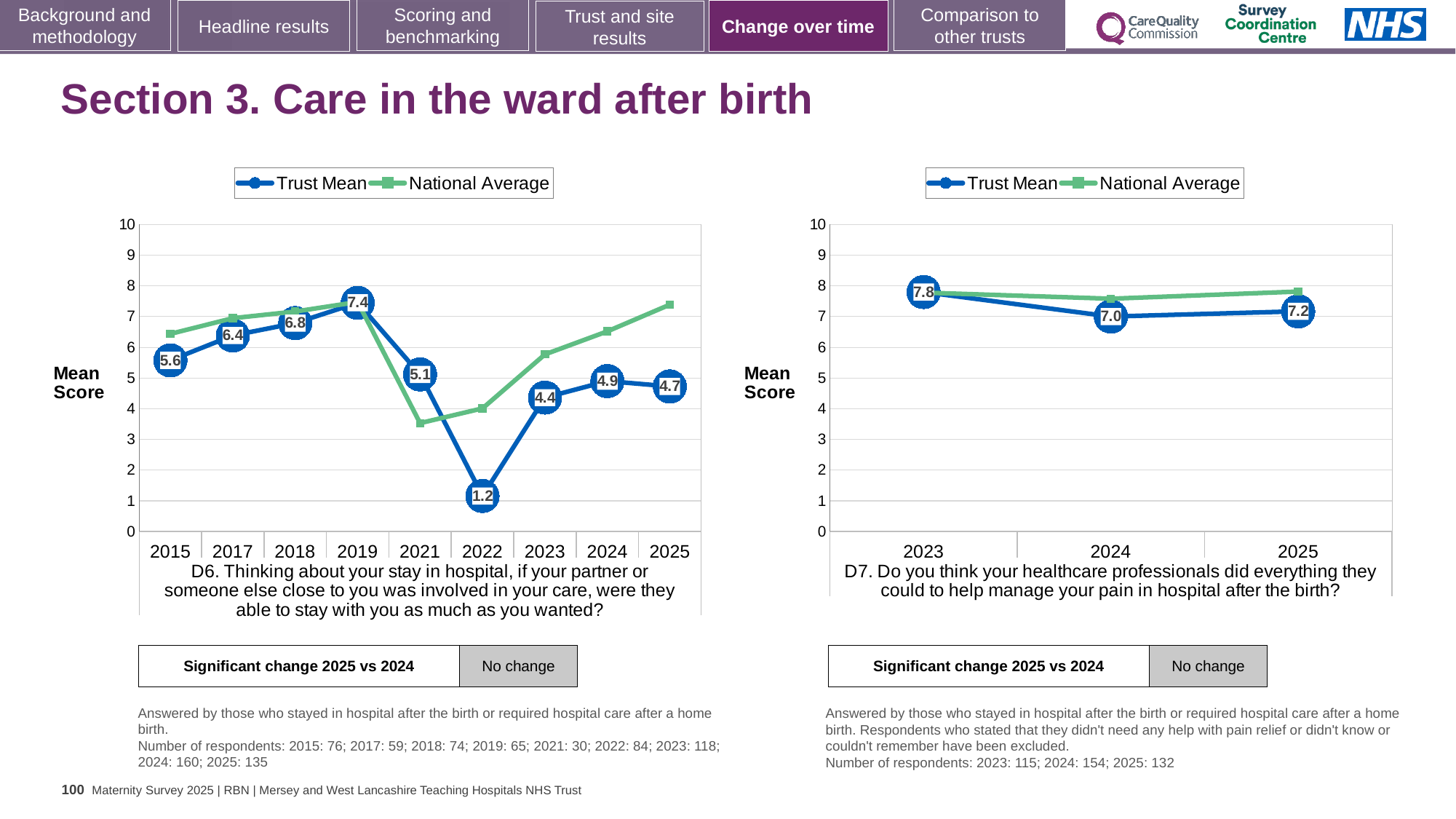
In the D6 chart on the left, is the National Average for 2025 greater or less than 7? greater In the D6 chart on the left, what is the difference between the Trust Mean scores for 2024 and 2025? 0.2 In the D7 chart on the right, what is the Trust Mean score for 2024? 7.0 In the D6 chart on the left, what is the Trust Mean score for 2019? 7.4 In the D6 chart on the left, how many years are shown on the x axis? 9 In the D6 chart on the left, which year has the lowest Trust Mean score? 2022 In the D7 chart on the right, how many series does the legend list? 2 In the D6 chart on the left, which year has the highest Trust Mean score? 2019 In the D7 chart on the right, which year has the highest Trust Mean score? 2023 What type of chart is the D7 chart on the right? Line chart In the D6 chart on the left, what is the Trust Mean score for 2022? 1.2 In the D7 chart on the right, what is the difference between the Trust Mean scores for 2023 and 2024? 0.8